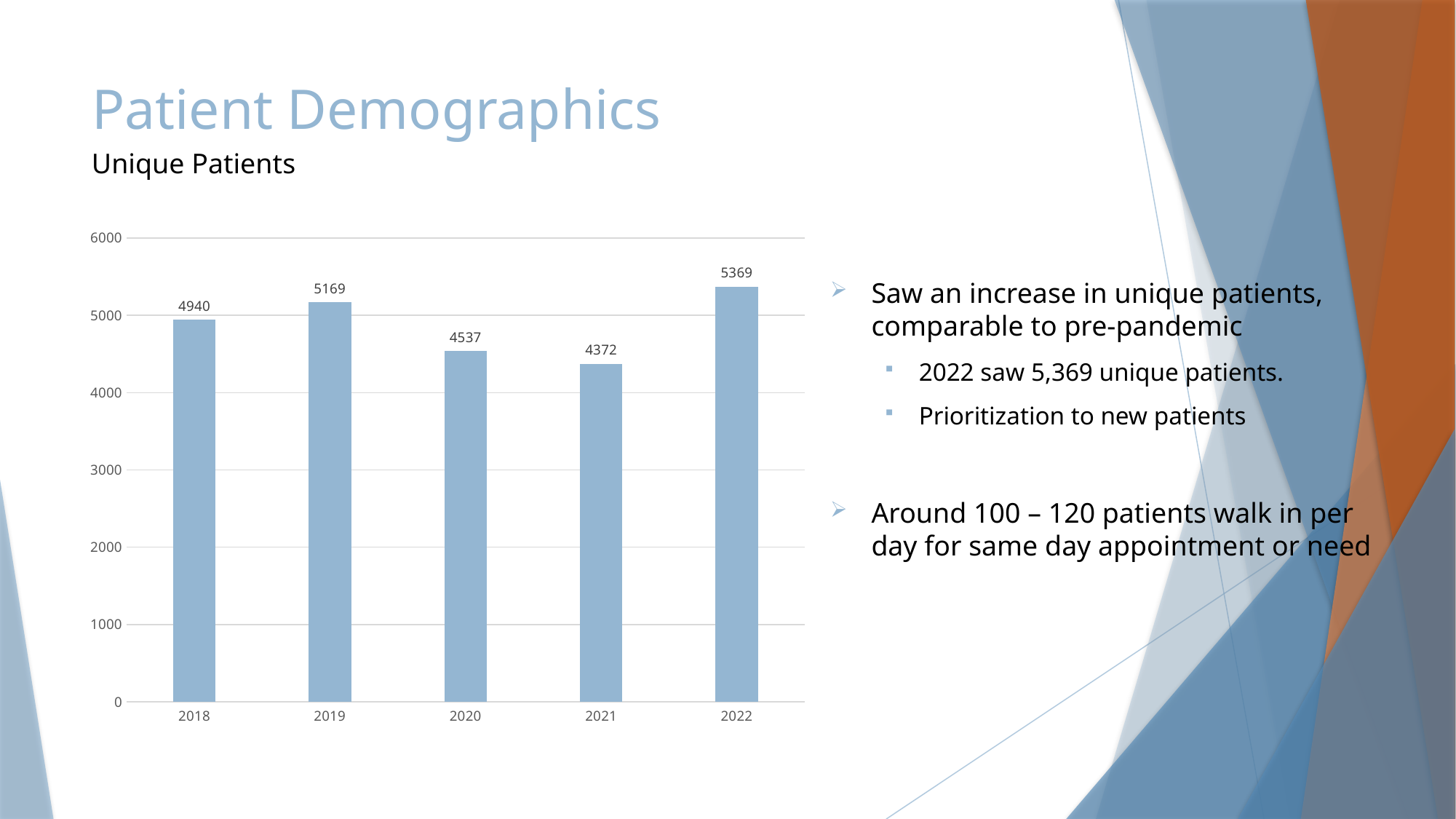
How many years are shown on the chart? 5 What is the number of unique patients in 2020? 4537 Did the number of unique patients rise or fall from 2019 to 2021? fall What is the difference in unique patients between 2019 and 2018? 229 Which year has the lowest number of unique patients? 2021 Which year had more unique patients, 2019 or 2020? 2019 What is the difference in unique patients between 2022 and 2021? 997 Which year has the highest number of unique patients? 2022 What is the number of unique patients in 2021? 4372 What kind of chart is shown on the slide? bar chart Is the value for 2021 greater or less than 5000? less What is the number of unique patients in 2018? 4940